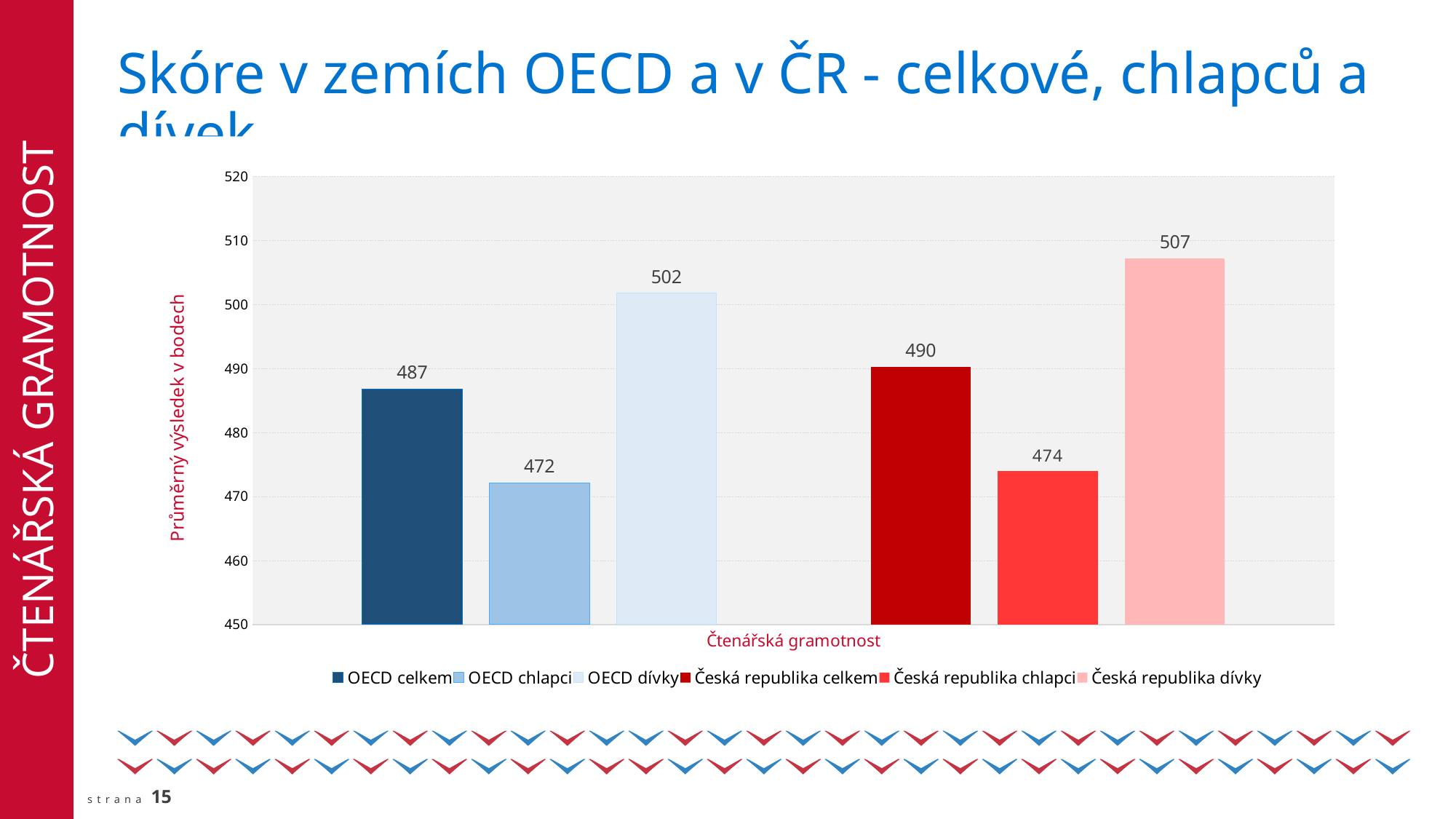
What is the label of the vertical axis? Průměrný výsledek v bodech What is the value for OECD celkem? 487 What is the value for Česká republika dívky? 507 How many series does the legend list? 6 What is the difference between OECD dívky and OECD chlapci? 30 Which is larger, Česká republika celkem or OECD celkem? Česká republika celkem Which series has the lowest value? OECD chlapci What is the difference between Česká republika dívky and Česká republika chlapci? 33 What kind of chart is shown? bar chart Is the value for OECD dívky greater or less than 500? greater What is the value for OECD chlapci? 472 Which series has the highest value? Česká republika dívky